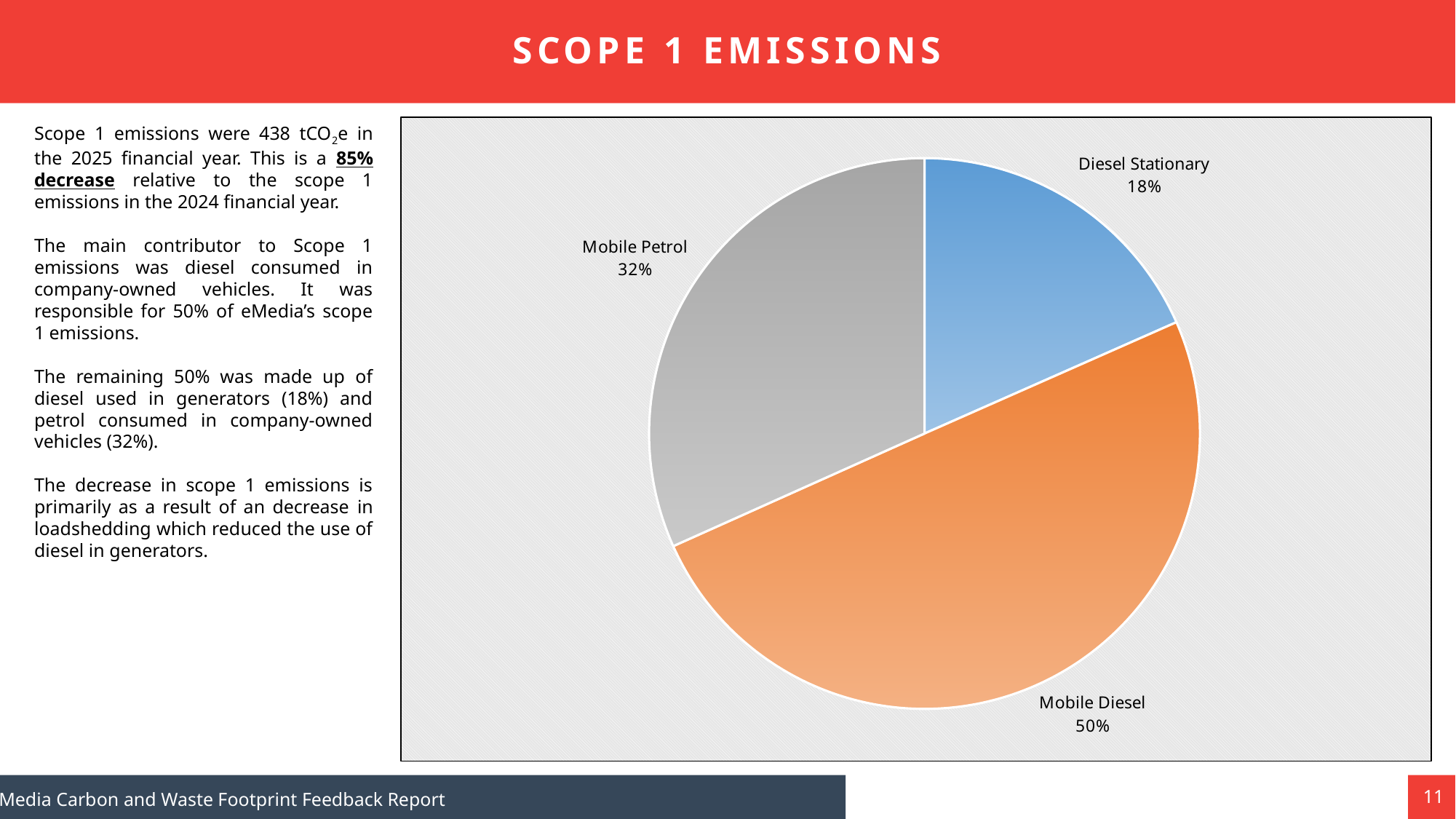
What share of Scope 1 emissions does Mobile Diesel account for? 50% What share of Scope 1 emissions does Diesel Stationary account for? 18% How many slices does the pie chart have? 3 What kind of chart is shown on the slide? pie chart What is the difference in percentage points between Mobile Petrol and Diesel Stationary? 14 What colour is the Mobile Diesel slice? orange Which category has the largest slice of the pie? Mobile Diesel What colour is the Diesel Stationary slice? blue What is the difference in percentage points between Mobile Diesel and Mobile Petrol? 18 Which category has the smallest slice of the pie? Diesel Stationary Which is larger, the Mobile Petrol slice or the Diesel Stationary slice? Mobile Petrol What share of Scope 1 emissions does Mobile Petrol account for? 32%